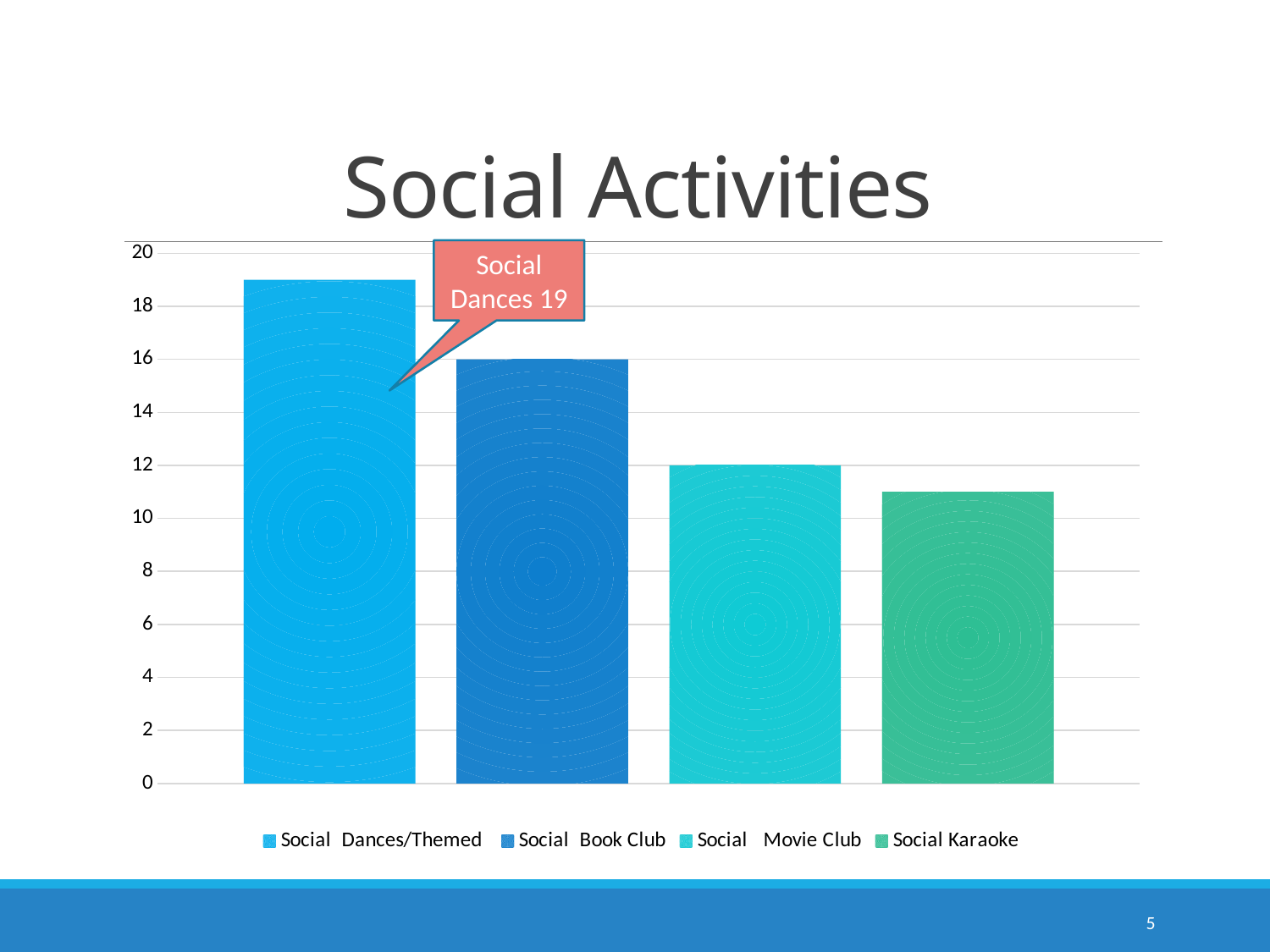
Which is larger, the value for Social Movie Club or Social Karaoke? Social Movie Club What is the value for Social Dances/Themed? 19 What is the title of the chart? Social Activities How many bars are shown in the chart? 4 What is the difference between the values for Social Book Club and Social Movie Club? 4 What is the value for Social Book Club? 16 Is the value for Social Karaoke greater or less than 12? less What is the value for Social Movie Club? 12 Which activity has the lowest value? Social Karaoke What is the difference between the values for Social Dances/Themed and Social Book Club? 3 Which activity has the highest value? Social Dances/Themed What kind of chart is shown on the slide? bar chart